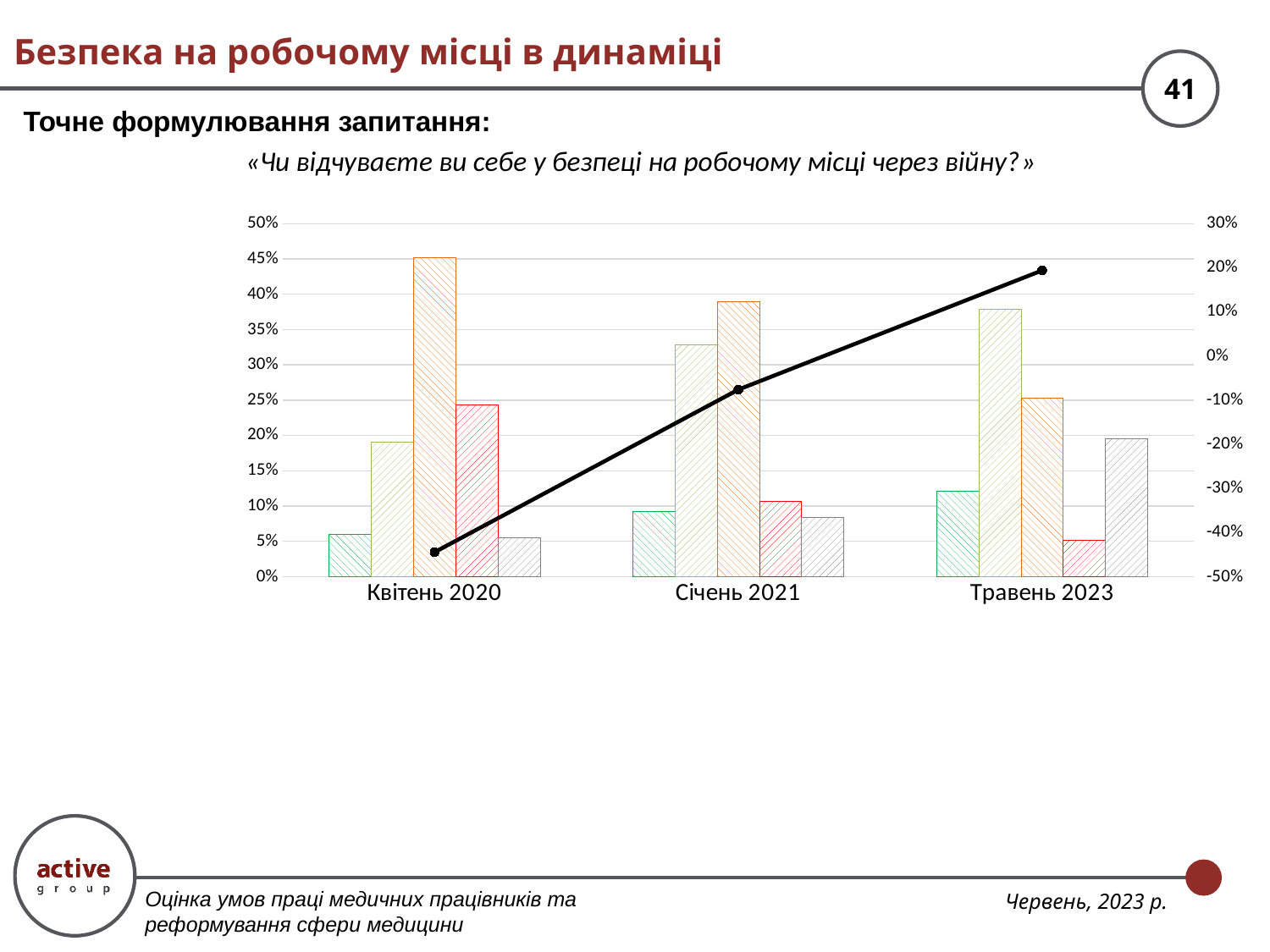
What kind of chart is shown on the slide? A bar chart combined with a line In which category is the light green bar the shortest? Квітень 2020 Is the value of the orange bar for Квітень 2020 greater or less than 40%? greater Does the black line rise or fall from Квітень 2020 to Травень 2023? It rises In which category is the orange bar the tallest? Квітень 2020 Is the value of the grey bar for Травень 2023 greater or less than 15%? greater Is the value of the red bar for Травень 2023 greater or less than 10%? less For Січень 2021, which is larger: the orange bar or the light green bar? The orange bar What is the maximum value shown on the left vertical axis? 50% How many time-period categories are shown on the x axis of the chart? 3